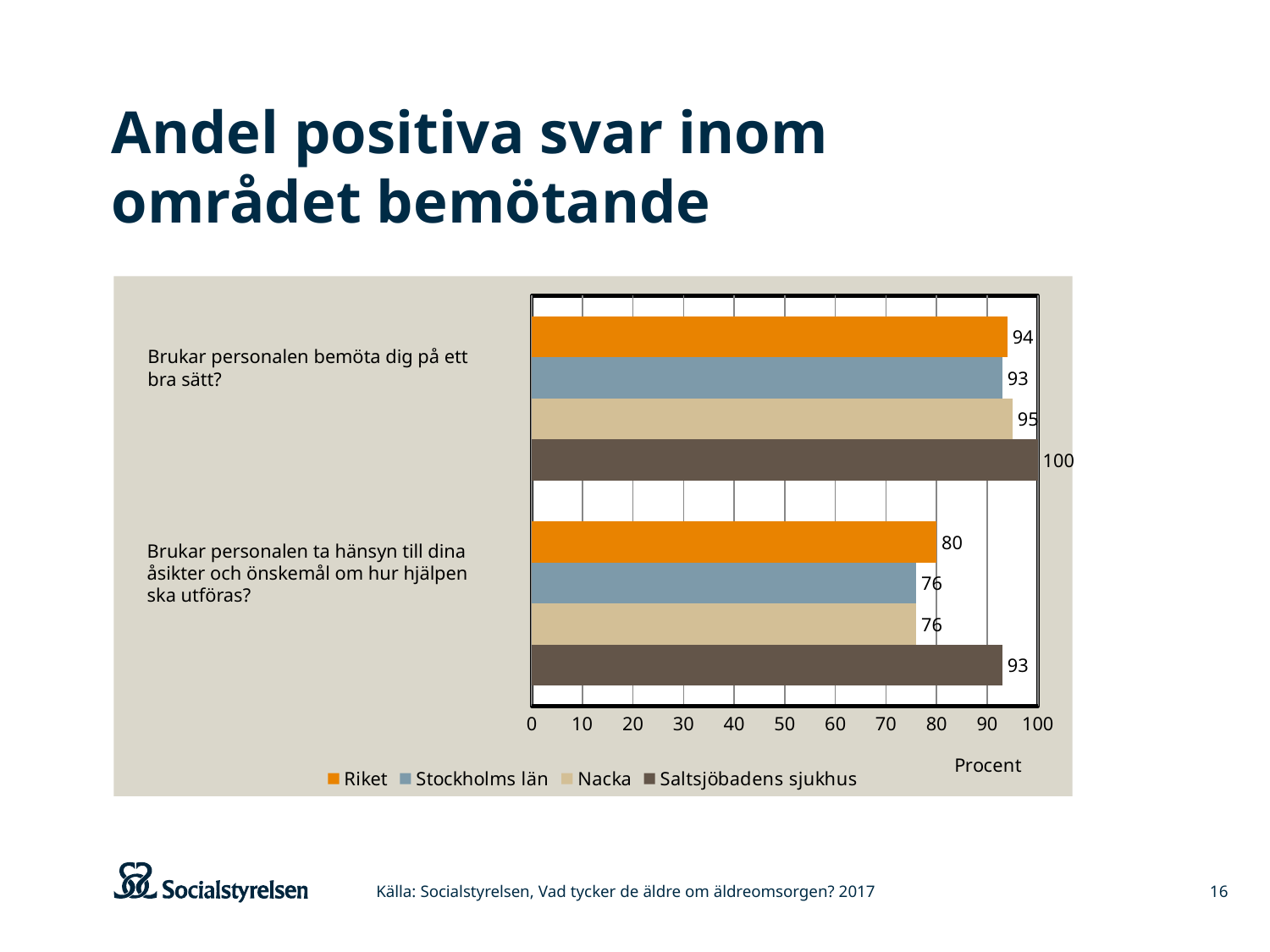
Which is larger: Riket or Nacka on the question "Brukar personalen bemöta dig på ett bra sätt?"? Nacka What is the value for Riket on the question "Brukar personalen ta hänsyn till dina åsikter och önskemål om hur hjälpen ska utföras?"? 80 What kind of chart is shown on the slide? Bar chart What is the value for Saltsjöbadens sjukhus on the question "Brukar personalen bemöta dig på ett bra sätt?"? 100 Which series has the lowest value on the question "Brukar personalen bemöta dig på ett bra sätt?"? Stockholms län What is the label of the x axis? Procent Which series has the highest value on the question "Brukar personalen ta hänsyn till dina åsikter och önskemål om hur hjälpen ska utföras?"? Saltsjöbadens sjukhus How many questions (categories) are shown on the chart? 2 What is the value for Nacka on the question "Brukar personalen bemöta dig på ett bra sätt?"? 95 How many series does the legend list? 4 What is the difference between Saltsjöbadens sjukhus and Riket on the question "Brukar personalen ta hänsyn till dina åsikter och önskemål om hur hjälpen ska utföras?"? 13 What is the value for Stockholms län on the question "Brukar personalen ta hänsyn till dina åsikter och önskemål om hur hjälpen ska utföras?"? 76